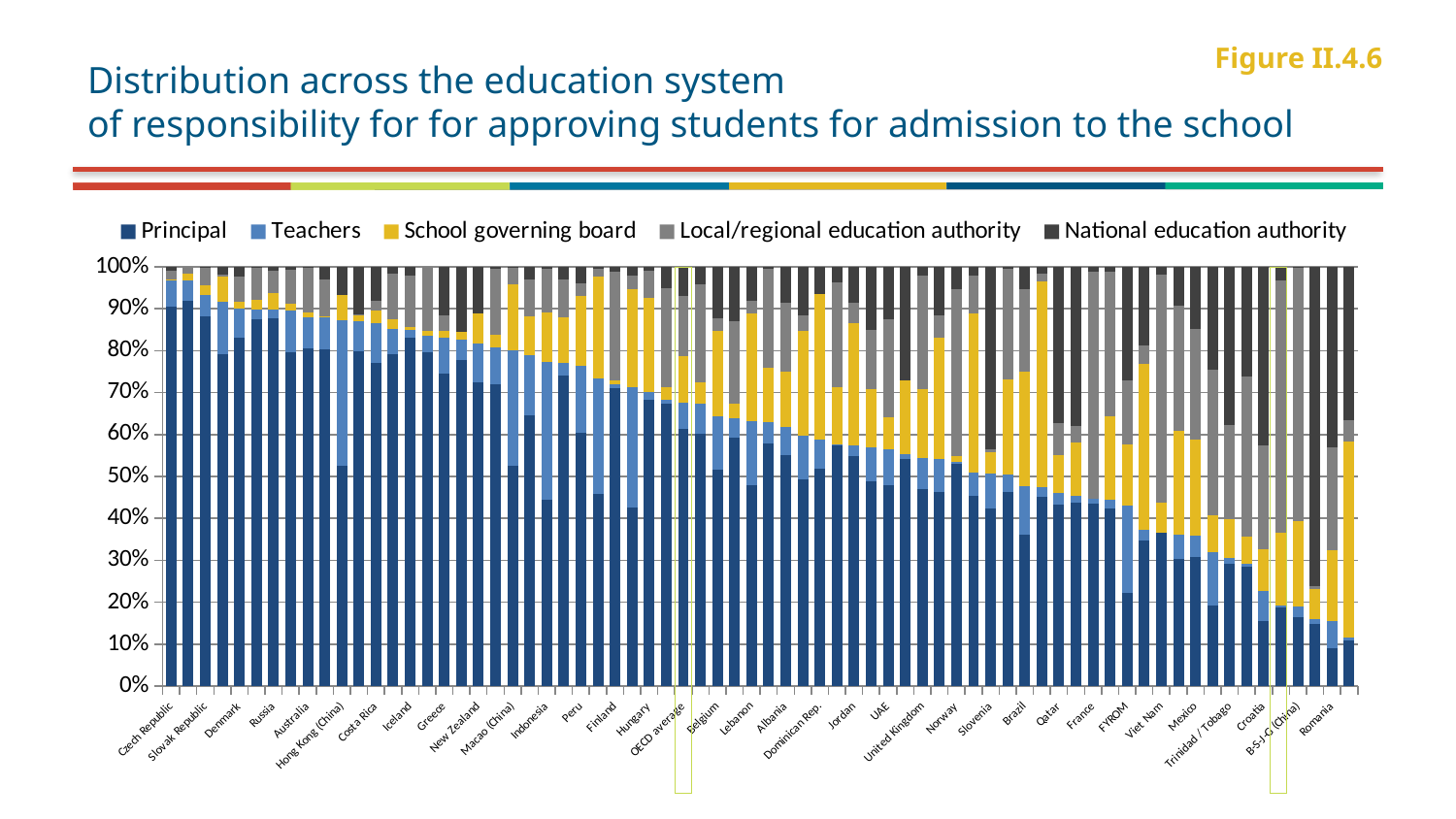
What are the five series listed in the legend? Principal, Teachers, School governing board, Local/regional education authority, National education authority What is the maximum value shown on the vertical axis? 100% What kind of chart is shown on the slide? Stacked bar chart Is the Principal share for the OECD average greater or less than 50%? greater Which series accounts for the largest share of the bar for the Czech Republic? Principal Which country has the lowest Principal share? Romania Does the Principal share rise or fall moving from left to right along the x axis? fall Is the Principal share for Romania greater or less than 20%? less Which has the larger Principal share, the Czech Republic or Romania? Czech Republic Is the Principal share for the Czech Republic greater or less than 80%? greater What is the figure number shown on the slide? Figure II.4.6 How many series does the legend list? 5